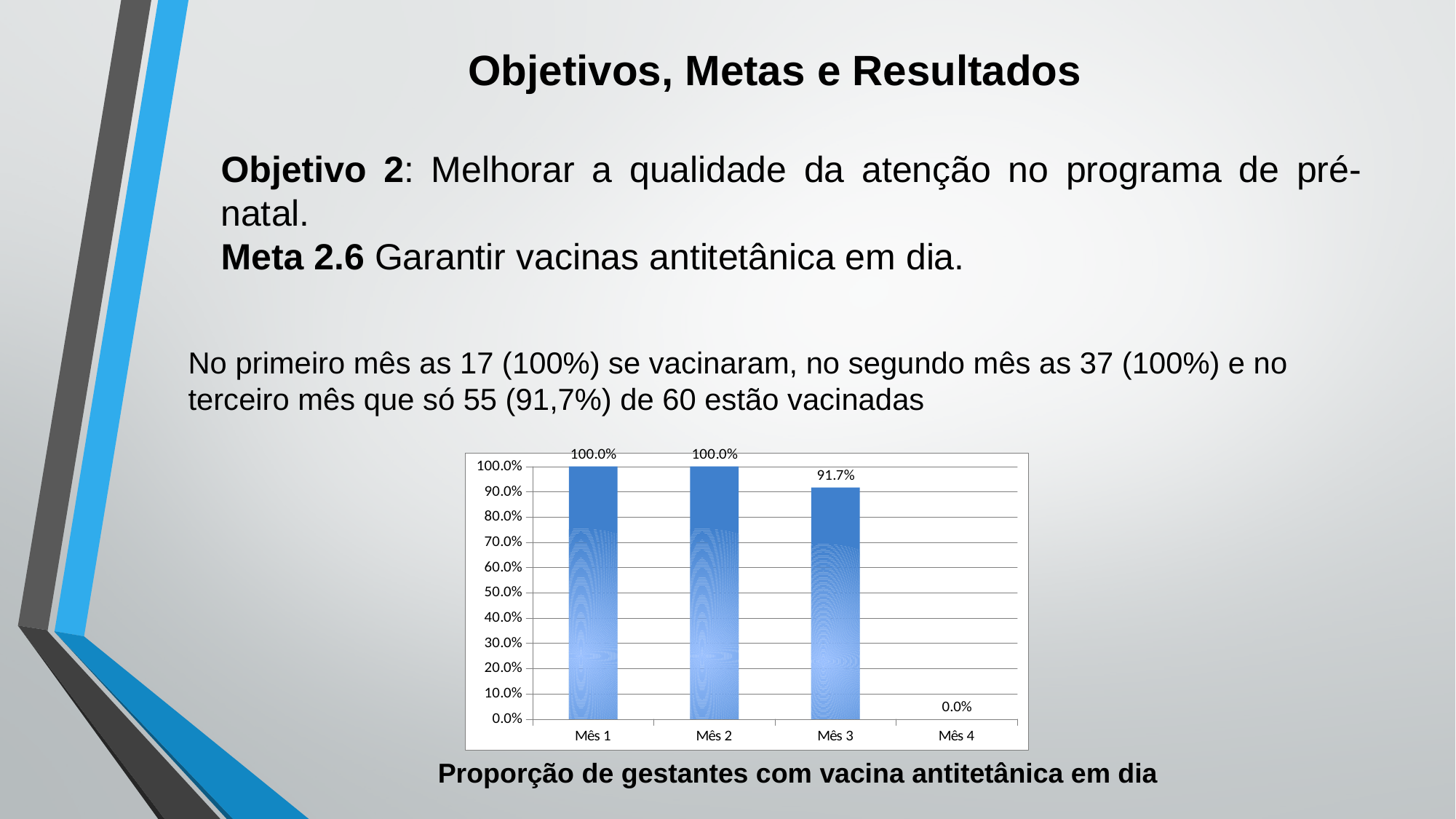
What is the value for Mês 4? 0.0% Which category has the lowest value? Mês 4 What is the difference between the values for Mês 2 and Mês 3? 8.3% How many categories are shown on the x axis? 4 What is the caption printed below the chart? Proporção de gestantes com vacina antitetânica em dia What kind of chart is shown on the slide? bar chart Which is larger, the value for Mês 1 or the value for Mês 3? Mês 1 What is the value for Mês 1? 100.0% Is the value for Mês 3 greater or less than 90.0%? greater Do the values rise or fall from Mês 2 to Mês 4? fall What is the value for Mês 3? 91.7% What is the highest value shown on the y axis? 100.0%